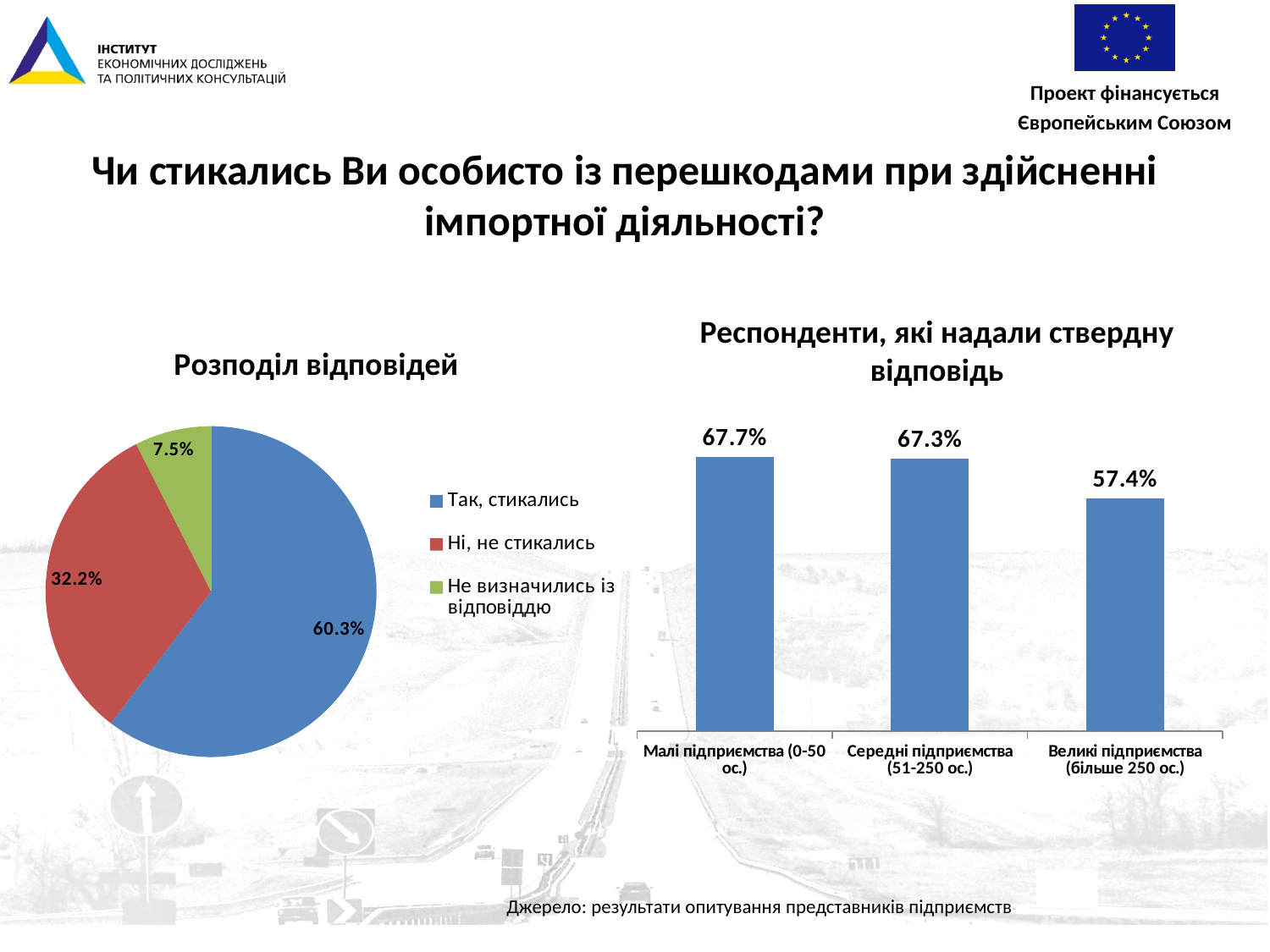
In the bar chart 'Респонденти, які надали ствердну відповідь', what is the value for 'Малі підприємства (0-50 ос.)'? 67.7% In the pie chart 'Розподіл відповідей', what share of respondents answered 'Ні, не стикались'? 32.2% In the bar chart 'Респонденти, які надали ствердну відповідь', which is larger: the value for 'Середні підприємства (51-250 ос.)' or for 'Великі підприємства (більше 250 ос.)'? Середні підприємства (51-250 ос.) What type of chart is the one on the left titled 'Розподіл відповідей'? pie chart In the pie chart 'Розподіл відповідей', what share of respondents answered 'Так, стикались'? 60.3% In the pie chart 'Розподіл відповідей', what share of respondents chose 'Не визначились із відповіддю'? 7.5% In the pie chart 'Розподіл відповідей', how many slices are there? 3 In the pie chart 'Розподіл відповідей', which answer has the smallest share? Не визначились із відповіддю In the bar chart 'Респонденти, які надали ствердну відповідь', what is the difference between the values for 'Малі підприємства (0-50 ос.)' and 'Великі підприємства (більше 250 ос.)'? 10.3 percentage points In the bar chart 'Респонденти, які надали ствердну відповідь', which category has the lowest value? Великі підприємства (більше 250 ос.) In the bar chart 'Респонденти, які надали ствердну відповідь', what is the value for 'Великі підприємства (більше 250 ос.)'? 57.4% What type of chart is the one on the right titled 'Респонденти, які надали ствердну відповідь'? bar chart